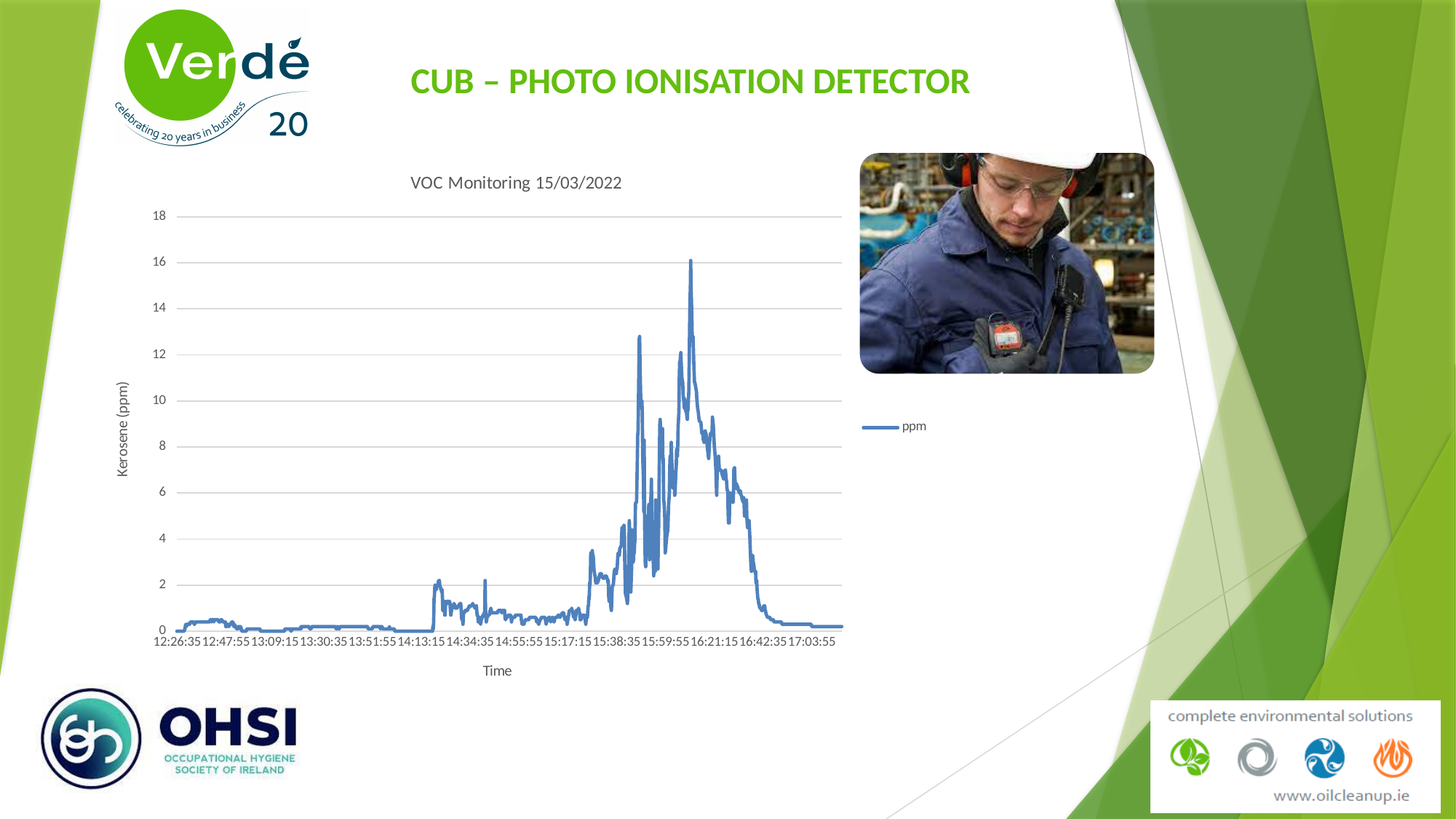
What kind of chart is shown on the slide? line chart Do the values generally rise or fall between 15:17:15 and 15:38:35? rise Is the value at 17:03:55 greater or less than 2? less Is the highest value reached by the line greater or less than 14? greater What is the highest value shown on the y axis? 18 Is the value at 12:26:35 greater or less than 2? less What is the title of the chart? VOC Monitoring 15/03/2022 What is the label of the series in the legend? ppm Do the values generally rise or fall between 16:21:15 and 16:42:35? fall How many series does the chart's legend list? 1 How many time labels are shown along the x axis? 14